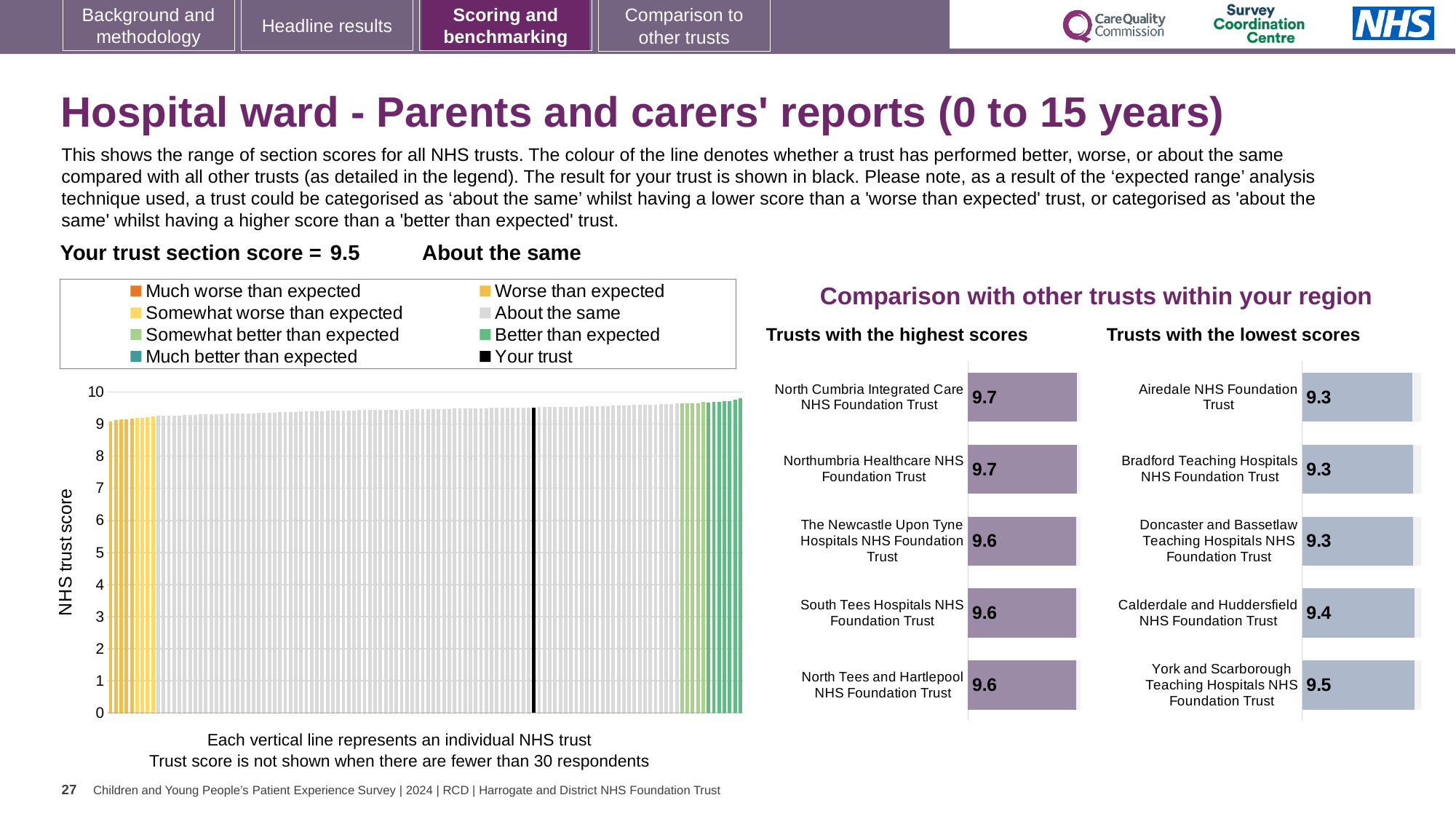
How many trusts are listed in the 'Trusts with the lowest scores' chart? 5 In the 'Trusts with the highest scores' chart, what is the score for South Tees Hospitals NHS Foundation Trust? 9.6 In the 'NHS trust score' chart on the left, is the value for the black 'Your trust' bar greater or less than 8? greater What kind of chart is the 'NHS trust score' chart on the left of the slide? Bar chart In the 'Trusts with the lowest scores' chart, which trust has the highest score? York and Scarborough Teaching Hospitals NHS Foundation Trust How many entries does the legend above the 'NHS trust score' chart list? 8 In the 'Trusts with the highest scores' chart, what is the score for North Cumbria Integrated Care NHS Foundation Trust? 9.7 In the 'Trusts with the lowest scores' chart, which has the larger score: Bradford Teaching Hospitals NHS Foundation Trust or Calderdale and Huddersfield NHS Foundation Trust? Calderdale and Huddersfield NHS Foundation Trust How many trusts are listed in the 'Trusts with the highest scores' chart? 5 In the 'Trusts with the lowest scores' chart, what is the score for Calderdale and Huddersfield NHS Foundation Trust? 9.4 In the 'Trusts with the highest scores' chart, what is the difference between the scores of Northumbria Healthcare NHS Foundation Trust and The Newcastle Upon Tyne Hospitals NHS Foundation Trust? 0.1 In the 'Trusts with the lowest scores' chart, what is the difference between the scores of York and Scarborough Teaching Hospitals NHS Foundation Trust and Airedale NHS Foundation Trust? 0.2